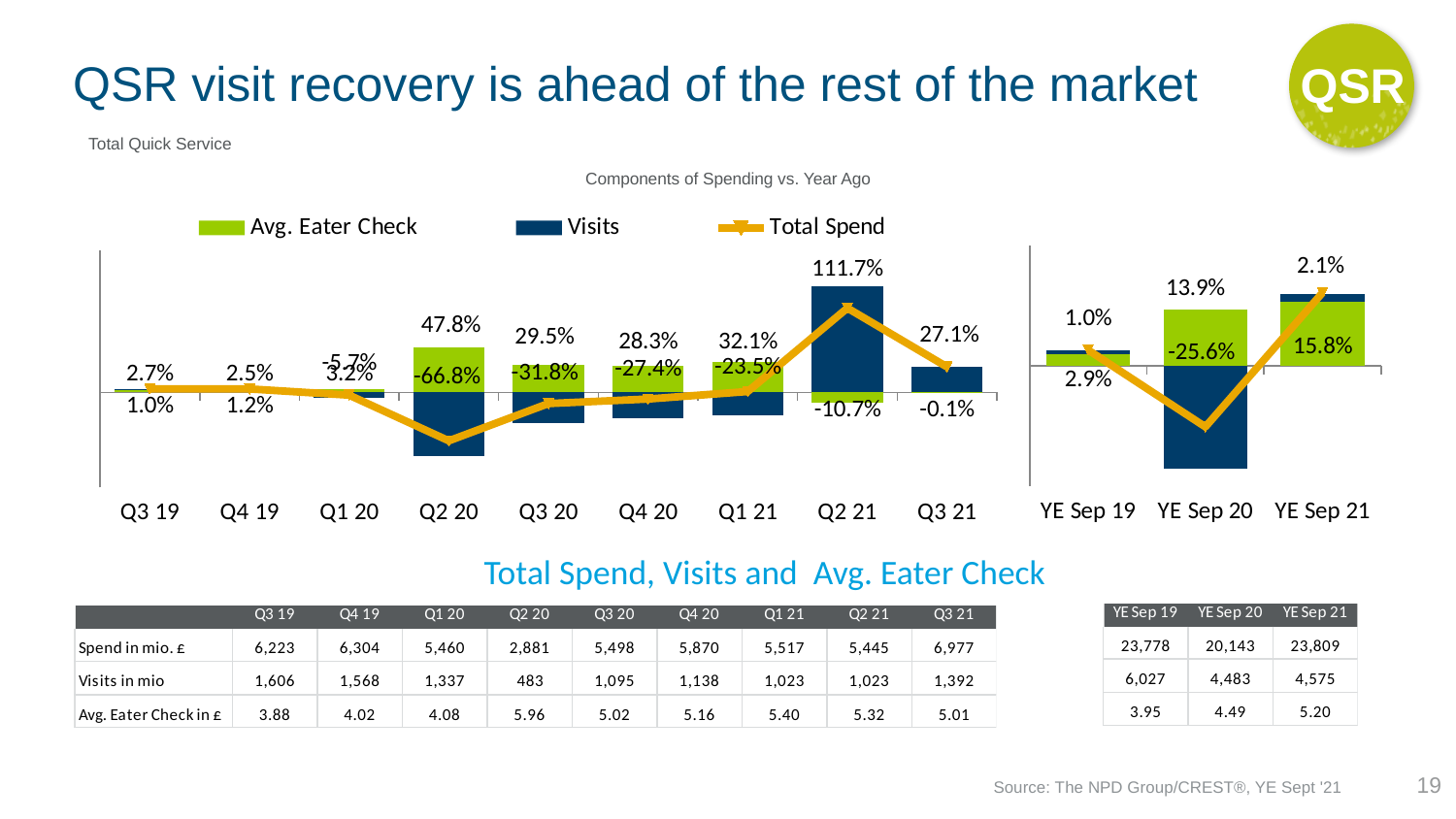
In the left chart, what is the difference between the Visits values for Q2 21 and Q3 21? 84.6 percentage points What kind of chart is the left chart (Q3 19 to Q3 21)? Bar chart with a line In the left chart, what is the Visits value for Q2 20? -66.8% In the left chart, which quarter has the highest Visits value? Q2 21 In the left chart, what is the Avg. Eater Check value for Q3 20? 29.5% How many series does the legend list for the charts? 3 How many periods are shown on the x axis of the right chart (YE Sep)? 3 In the left chart, which quarter has the lowest Visits value? Q2 20 In the right chart, what is the Avg. Eater Check value for YE Sep 21? 15.8% In the right chart, what is the Visits value for YE Sep 20? -25.6% How many quarters are shown on the x axis of the left chart? 9 In the left chart, what is the Visits value for Q2 21? 111.7%